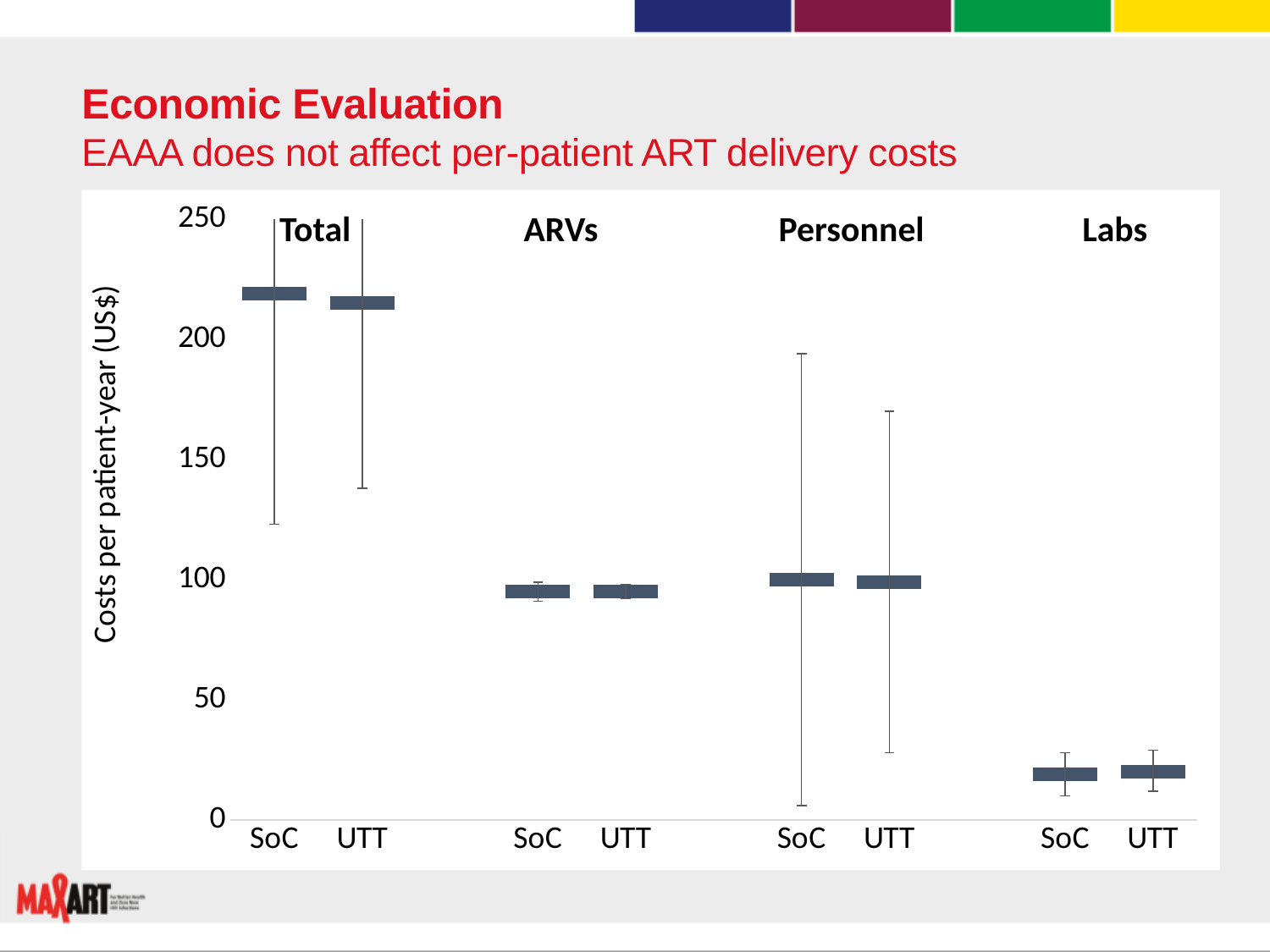
Is the Labs cost for SoC greater or less than 50? less Which cost category has the highest per-patient-year costs? Total Is the Personnel cost for UTT greater or less than 50? greater Which is larger, the Total cost for SoC or the Labs cost for SoC? Total cost for SoC What are the two arms compared within each cost category on the x axis? SoC and UTT Is the Total cost for UTT greater or less than 200? greater Which cost category has the lowest per-patient-year costs? Labs What is the label on the vertical axis of the chart? Costs per patient-year (US$) How many cost categories are shown along the top of the chart? 4 Which cost category shows the widest error bars (uncertainty range)? Personnel